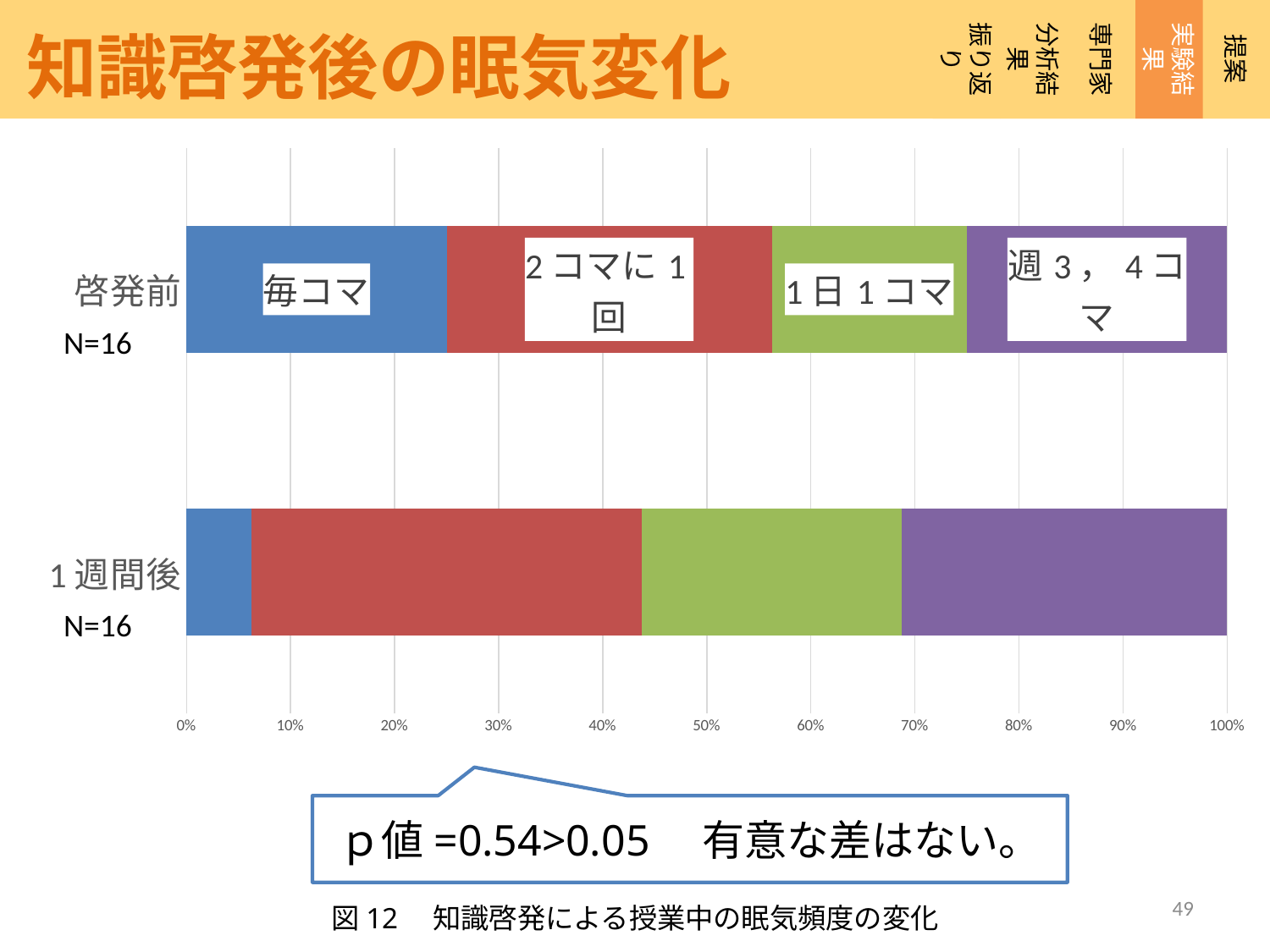
Is the 毎コマ segment of the 1週間後 bar greater or less than 10%? less Is the 週3，4コマ segment of the 啓発前 bar greater or less than 20%? greater Which bar has the larger 1日1コマ segment, 啓発前 or 1週間後? 1週間後 Is the 毎コマ segment of the 啓発前 bar greater or less than 20%? greater Which bar has the larger 2コマに1回 segment, 啓発前 or 1週間後? 1週間後 How many segments (series) make up each stacked bar? 4 What kind of chart is shown on the slide? Stacked bar chart Which bar has the larger 毎コマ segment, 啓発前 or 1週間後? 啓発前 What is the sample size (N) shown for each bar in the chart? N=16 What p value is stated in the callout below the chart? 0.54 How many bars (categories) are plotted in the chart? 2